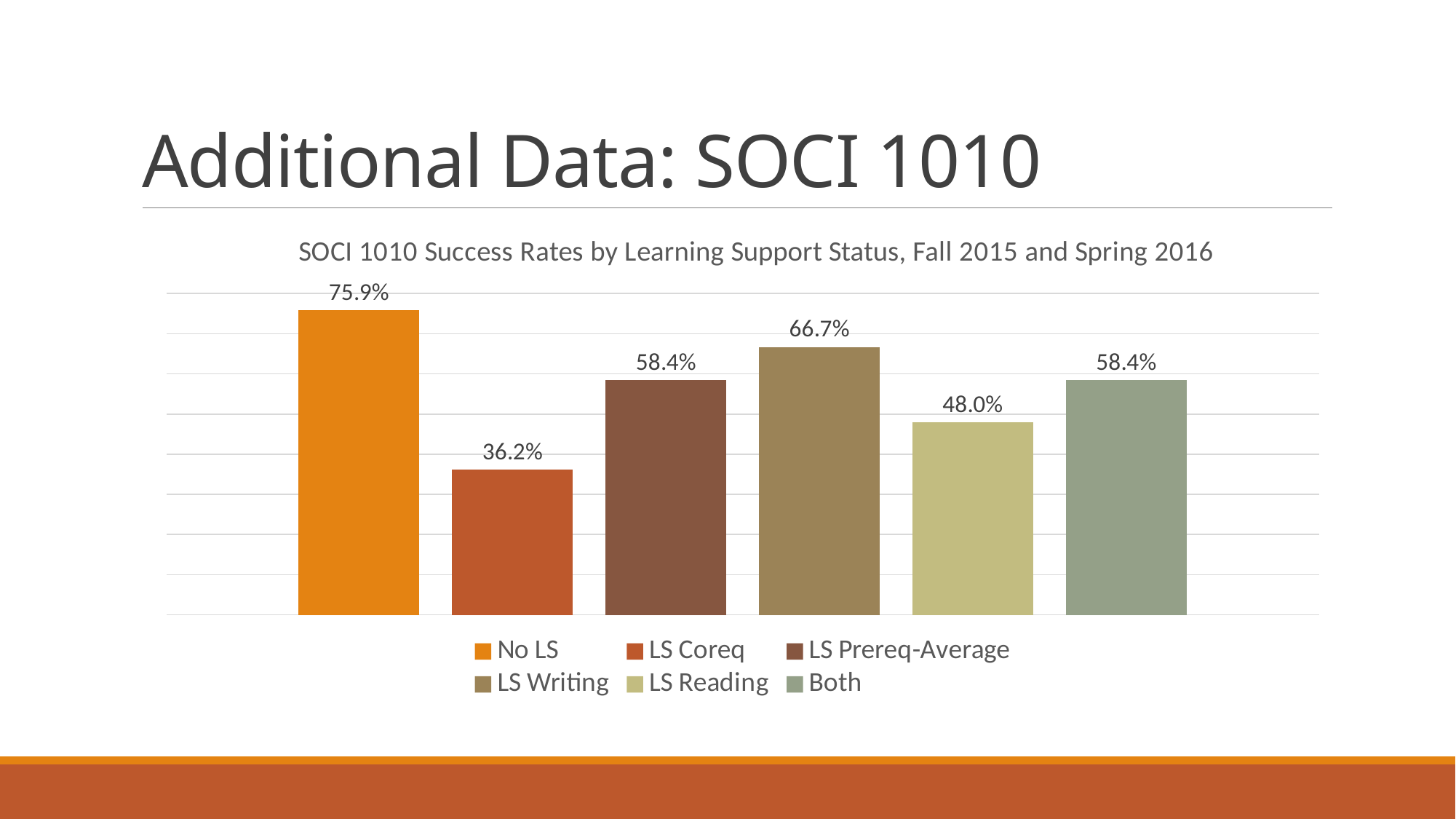
Which learning support status has the highest success rate? No LS What is the difference between the success rates for No LS and LS Coreq? 39.7% How many learning support status categories are shown in the chart? 6 Which has a higher success rate, LS Writing or LS Prereq-Average? LS Writing What type of chart is shown on the slide? Bar chart What is the success rate for LS Reading? 48.0% What is the success rate for LS Coreq? 36.2% What is the title of the chart? SOCI 1010 Success Rates by Learning Support Status, Fall 2015 and Spring 2016 What is the success rate for No LS? 75.9% Which learning support status has the lowest success rate? LS Coreq What is the difference between the success rates for LS Writing and LS Reading? 18.7% What is the success rate for LS Writing? 66.7%